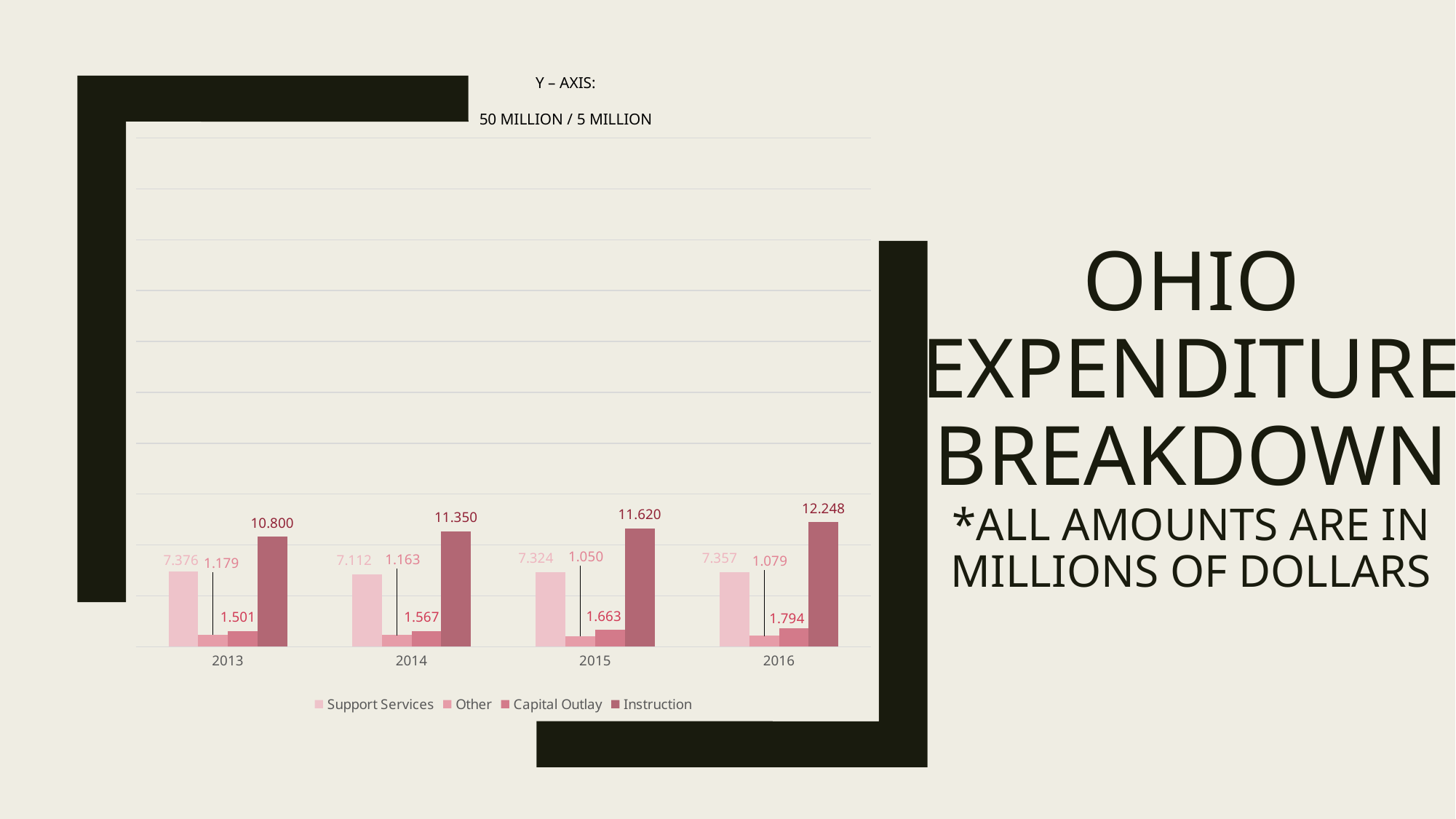
What is the value for Other in 2014? 1.163 What is the value for Support Services in 2013? 7.376 What is the difference between the Instruction values for 2016 and 2013? 1.448 What is the value for Instruction in 2016? 12.248 What is the value for Capital Outlay in 2015? 1.663 How many years are shown on the x axis? 4 Does the Instruction value rise or fall from 2013 to 2016? rise Which is larger, Support Services in 2013 or Support Services in 2014? Support Services in 2013 What kind of chart is shown on the slide? bar chart In which year is the Other value lowest? 2015 How many series does the legend list? 4 In which year is the Instruction value highest? 2016